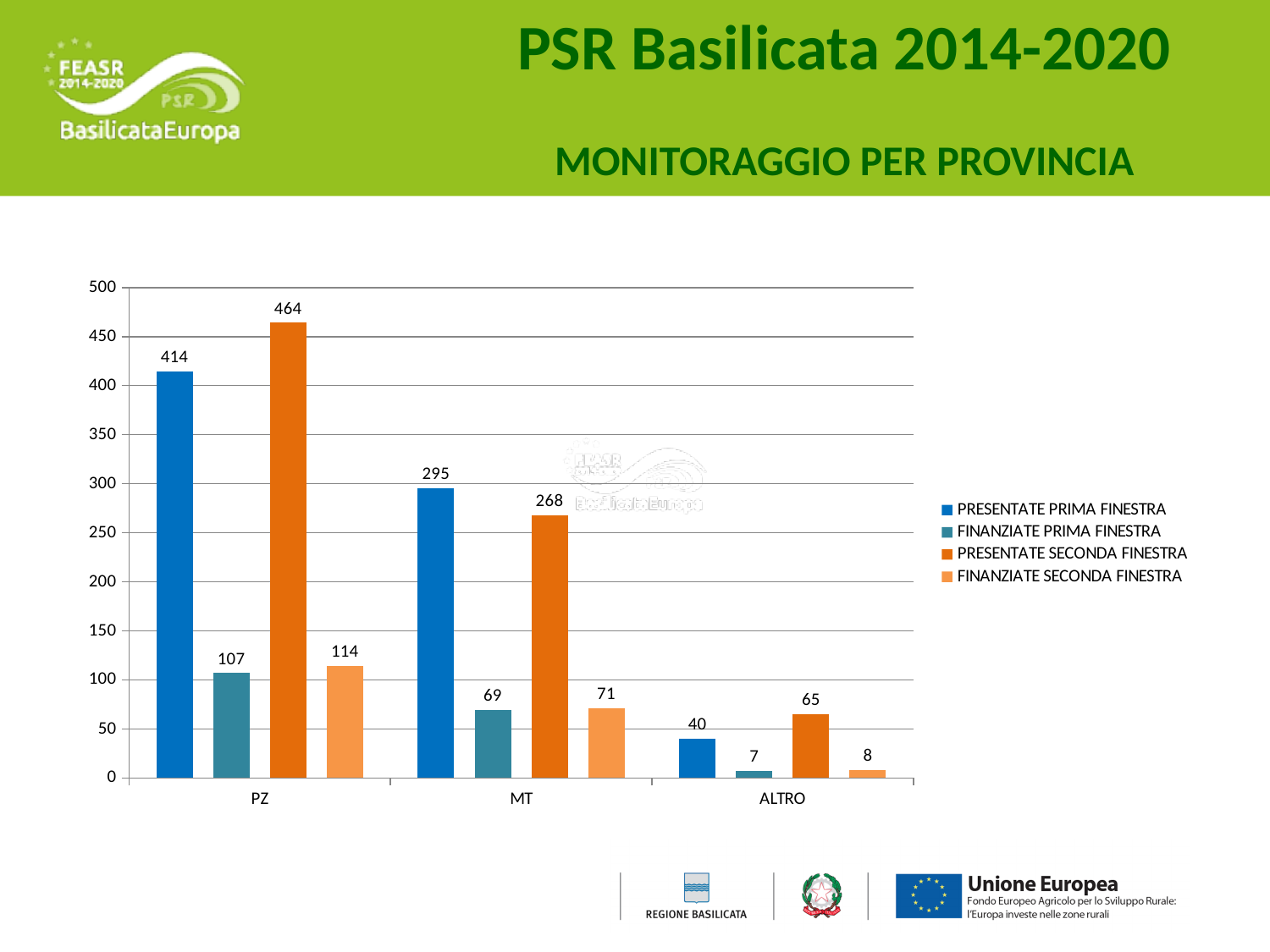
Which category has the lowest value for FINANZIATE SECONDA FINESTRA? ALTRO Which category has the highest value for PRESENTATE SECONDA FINESTRA? PZ Is the value of PRESENTATE SECONDA FINESTRA for MT greater or less than 250? greater What is the difference between PRESENTATE SECONDA FINESTRA and PRESENTATE PRIMA FINESTRA for PZ? 50 What is the value of PRESENTATE PRIMA FINESTRA for PZ? 414 What is the value of FINANZIATE PRIMA FINESTRA for ALTRO? 7 What is the value of FINANZIATE SECONDA FINESTRA for MT? 71 Which is larger for MT: PRESENTATE PRIMA FINESTRA or PRESENTATE SECONDA FINESTRA? PRESENTATE PRIMA FINESTRA How many categories are shown on the x axis? 3 What is the difference between PRESENTATE PRIMA FINESTRA for MT and for ALTRO? 255 What kind of chart is shown on the slide? Bar chart How many series does the legend list? 4